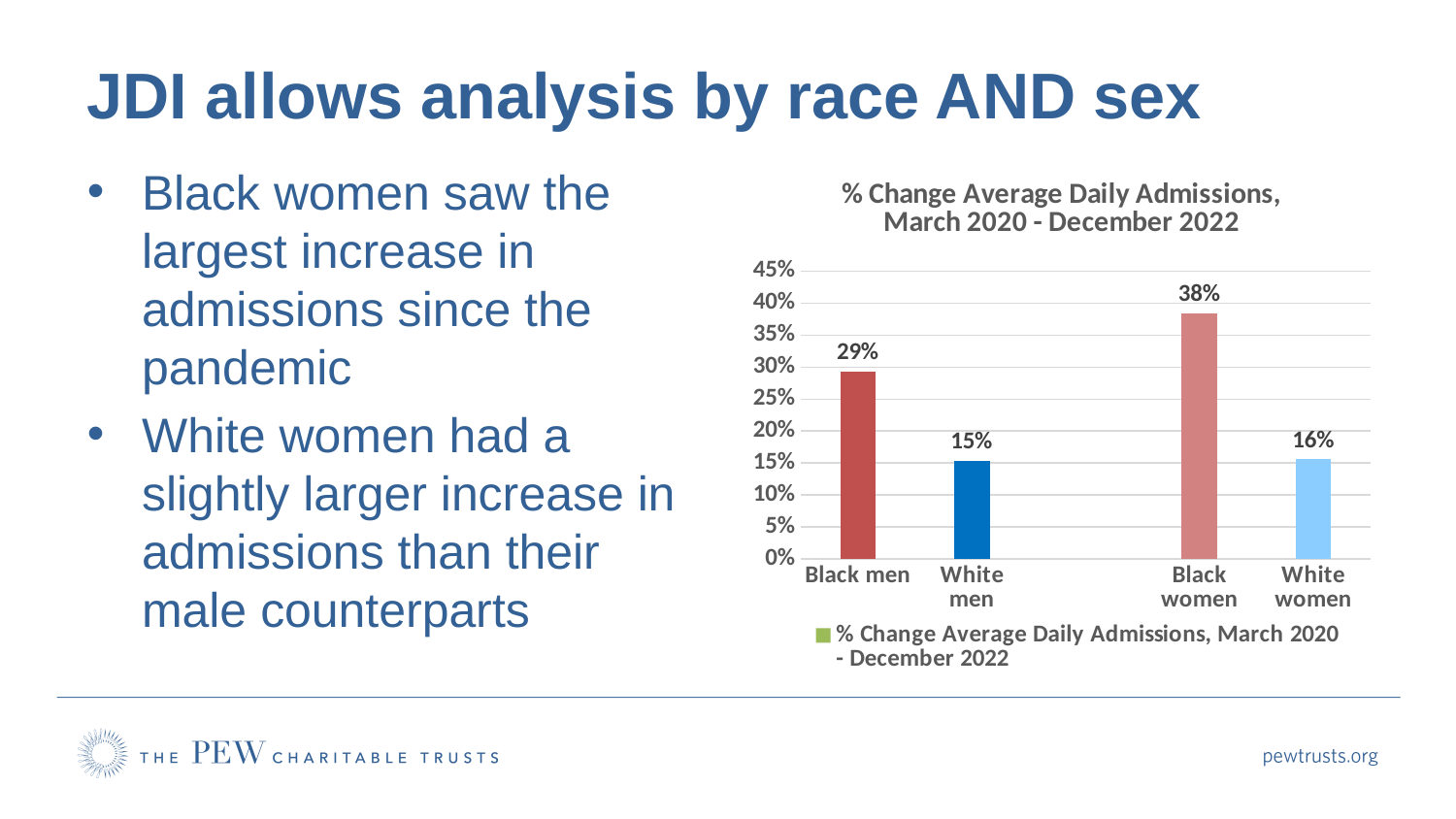
What is the value for Black women? 38% What is the value for Black men? 29% Is the value for Black women greater or less than 35%? greater What is the value for White men? 15% Which category has the lowest value? White men Which is larger, the value for Black men or the value for White women? Black men What is the title of the chart? % Change Average Daily Admissions, March 2020 - December 2022 What is the value for White women? 16% Which category has the highest value? Black women What kind of chart is shown on the slide? bar chart How many categories are shown on the x axis? 4 What is the difference between the values for Black women and Black men? 9%